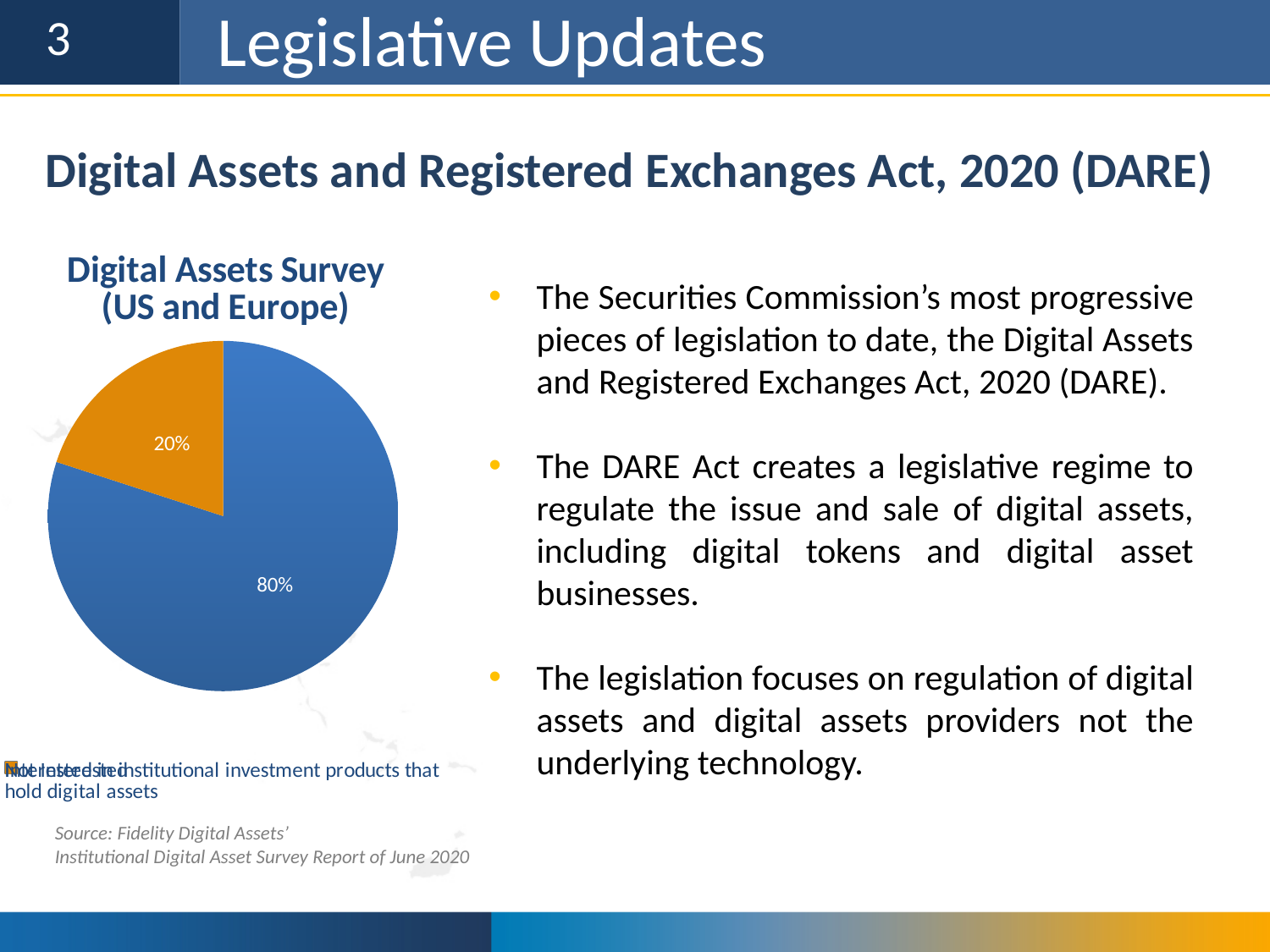
What share of the pie does the orange slice represent? 20% Which slice of the pie chart is the largest? the blue slice (80%) What kind of chart is shown on the slide? pie chart What source is cited below the chart? Fidelity Digital Assets' Institutional Digital Asset Survey Report of June 2020 Which slice of the pie chart is the smallest? the orange slice (20%) Is the blue slice or the orange slice larger in the pie chart? the blue slice What is the total of the two slice percentages shown on the pie chart? 100% How many slices does the pie chart have? 2 What percentage is shown on the orange slice of the pie chart? 20% What percentage is shown on the blue slice of the pie chart? 80% What is the title of the chart on the slide? Digital Assets Survey (US and Europe) What is the difference in percentage points between the blue slice and the orange slice? 60 percentage points